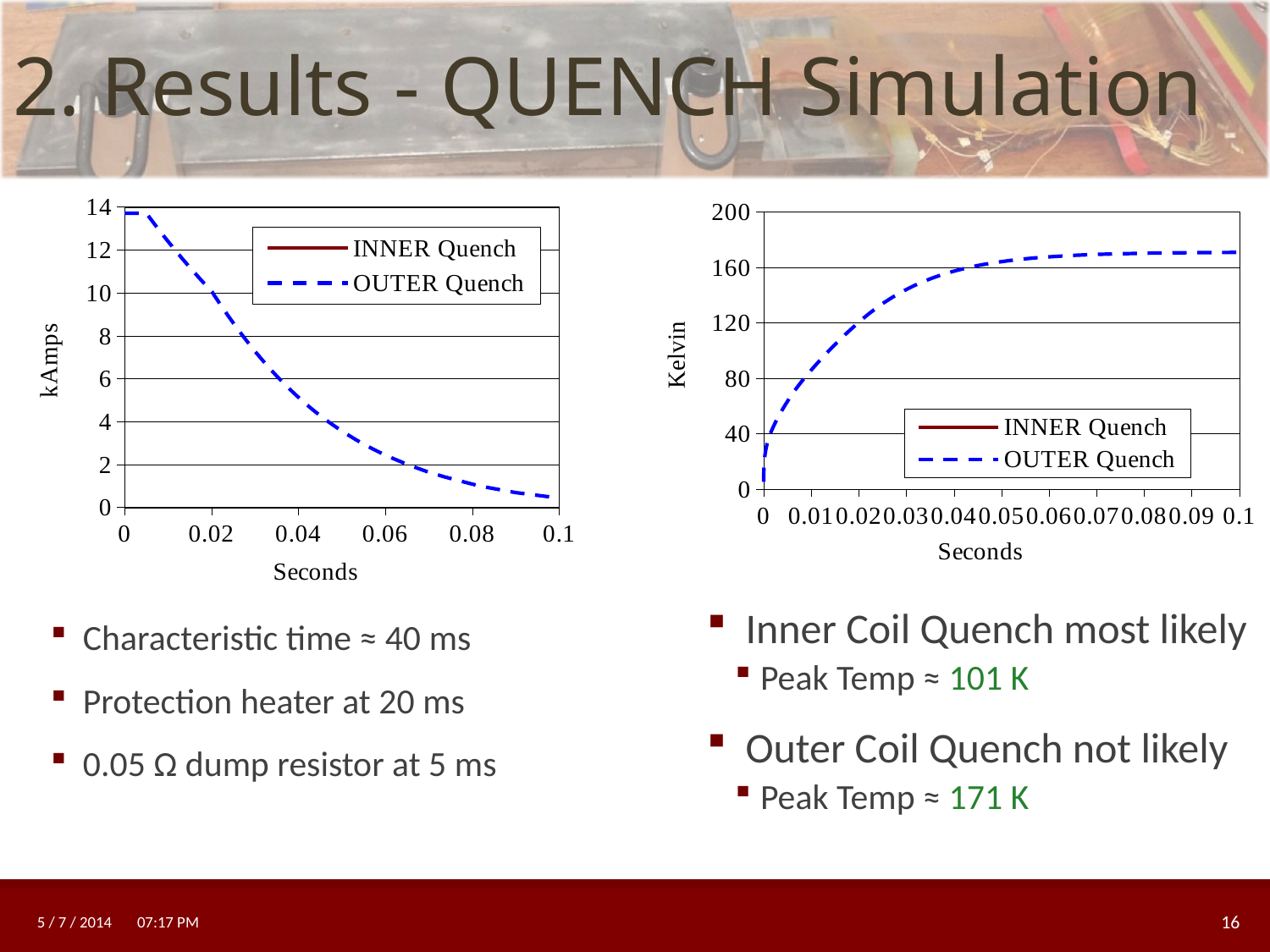
In the left chart (kAmps), does the OUTER Quench line rise or fall as time increases along the x axis? fall In the left chart (kAmps), is the OUTER Quench value at 0 seconds greater or less than 12? greater How many series does the legend of the left chart (kAmps) list? 2 In the right chart (Kelvin), is the OUTER Quench value at 0.01 seconds greater or less than 120? less How many series does the legend of the right chart (Kelvin) list? 2 In the right chart (Kelvin), is the OUTER Quench value at 0.1 seconds greater or less than 160? greater What is the y-axis label of the left chart? kAmps What kind of chart is the right chart with the Kelvin axis? line chart What kind of chart is the left chart with the kAmps axis? line chart What is the x-axis label of the right chart? Seconds In the right chart (Kelvin), does the OUTER Quench line rise or fall as time increases along the x axis? rise